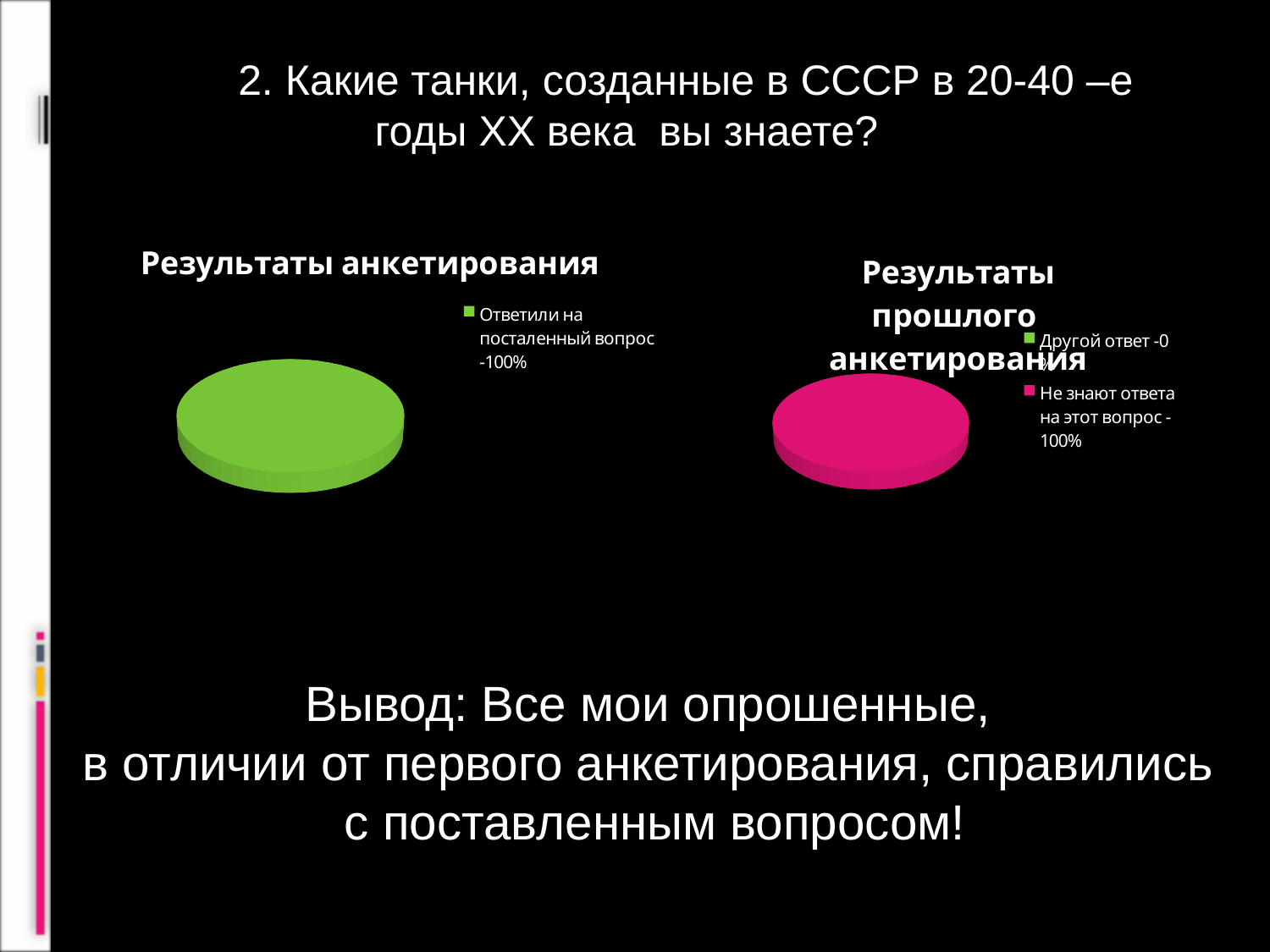
What colour is the pie in the right chart "Результаты прошлого анкетирования"? pink How many entries does the legend of the right chart "Результаты прошлого анкетирования" list? 2 What colour is the pie in the left chart "Результаты анкетирования"? green In the right chart "Результаты прошлого анкетирования", which category has the largest share? Не знают ответа на этот вопрос In the right chart "Результаты прошлого анкетирования", which category has the smallest share? Другой ответ What type of chart is the right chart titled "Результаты прошлого анкетирования"? pie chart In the right chart "Результаты прошлого анкетирования", what share is given for "Не знают ответа на этот вопрос"? 100% In the right chart "Результаты прошлого анкетирования", which is larger: "Другой ответ" or "Не знают ответа на этот вопрос"? Не знают ответа на этот вопрос What type of chart is the left chart titled "Результаты анкетирования"? pie chart How many entries does the legend of the left chart "Результаты анкетирования" list? 1 In the right chart "Результаты прошлого анкетирования", what share is given for "Другой ответ"? 0% In the left chart "Результаты анкетирования", what share is given for "Ответили на посталенный вопрос"? 100%